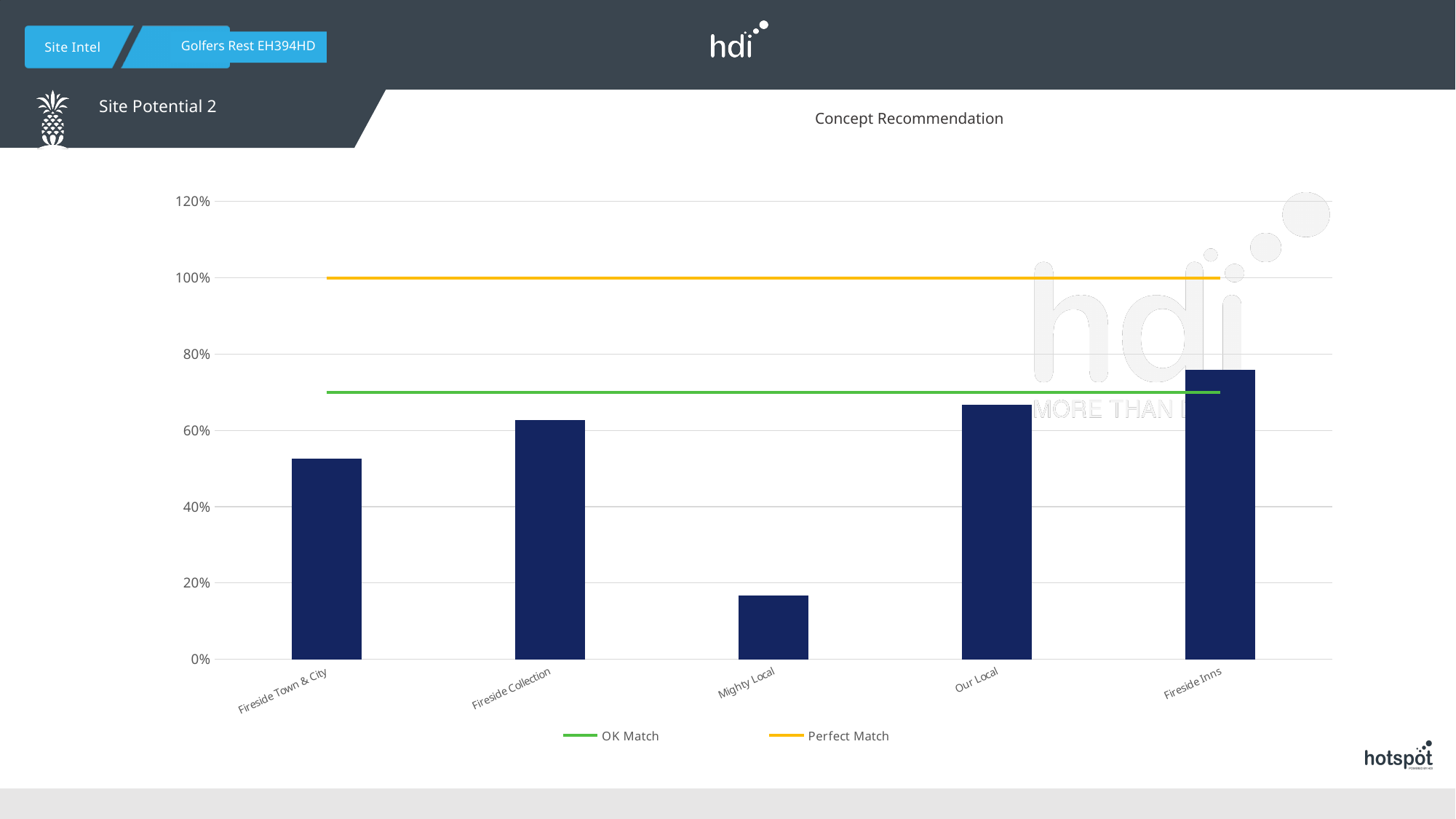
What kind of chart is shown on the slide? bar chart Is the value for Fireside Inns greater or less than 80%? less Which category has the lowest bar in the chart? Mighty Local Which category has the highest bar in the chart? Fireside Inns What is the title of the chart? Concept Recommendation How many categories are shown on the x axis of the chart? 5 Is the value for Fireside Collection greater or less than 60%? greater At what level on the y axis is the Perfect Match line drawn? 100% How many entries does the chart's legend list? 2 Is the value for Mighty Local greater or less than 20%? less Which is larger, the value for Our Local or the value for Fireside Town & City? Our Local